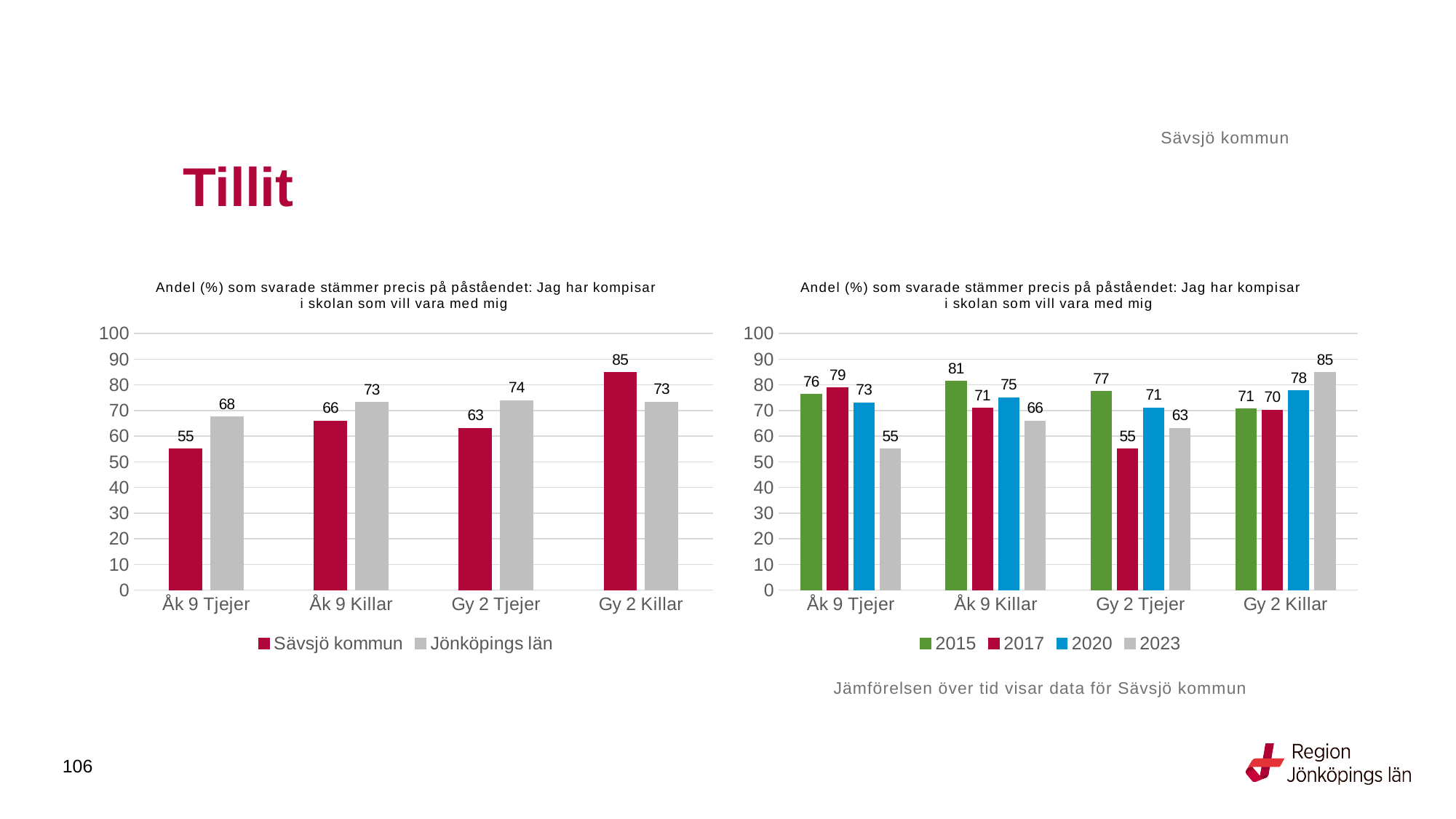
In the right chart, which category has the lowest value for 2023? Åk 9 Tjejer What kind of chart is the right chart? Bar chart In the left chart, which is larger for Gy 2 Killar: Sävsjö kommun or Jönköpings län? Sävsjö kommun In the right chart, how many series does the legend list? 4 In the right chart, what is the difference between 2015 and 2023 for Åk 9 Tjejer? 21 In the left chart, which category has the highest value for Sävsjö kommun? Gy 2 Killar In the left chart, what is the difference between Sävsjö kommun and Jönköpings län for Åk 9 Tjejer? 13 In the right chart, what is the value for 2023 for Gy 2 Tjejer? 63 In the left chart, how many series does the legend list? 2 In the right chart, what is the value for 2020 for Åk 9 Killar? 75 In the left chart, what is the value for Jönköpings län for Gy 2 Tjejer? 74 In the left chart, what is the value for Sävsjö kommun for Åk 9 Tjejer? 55